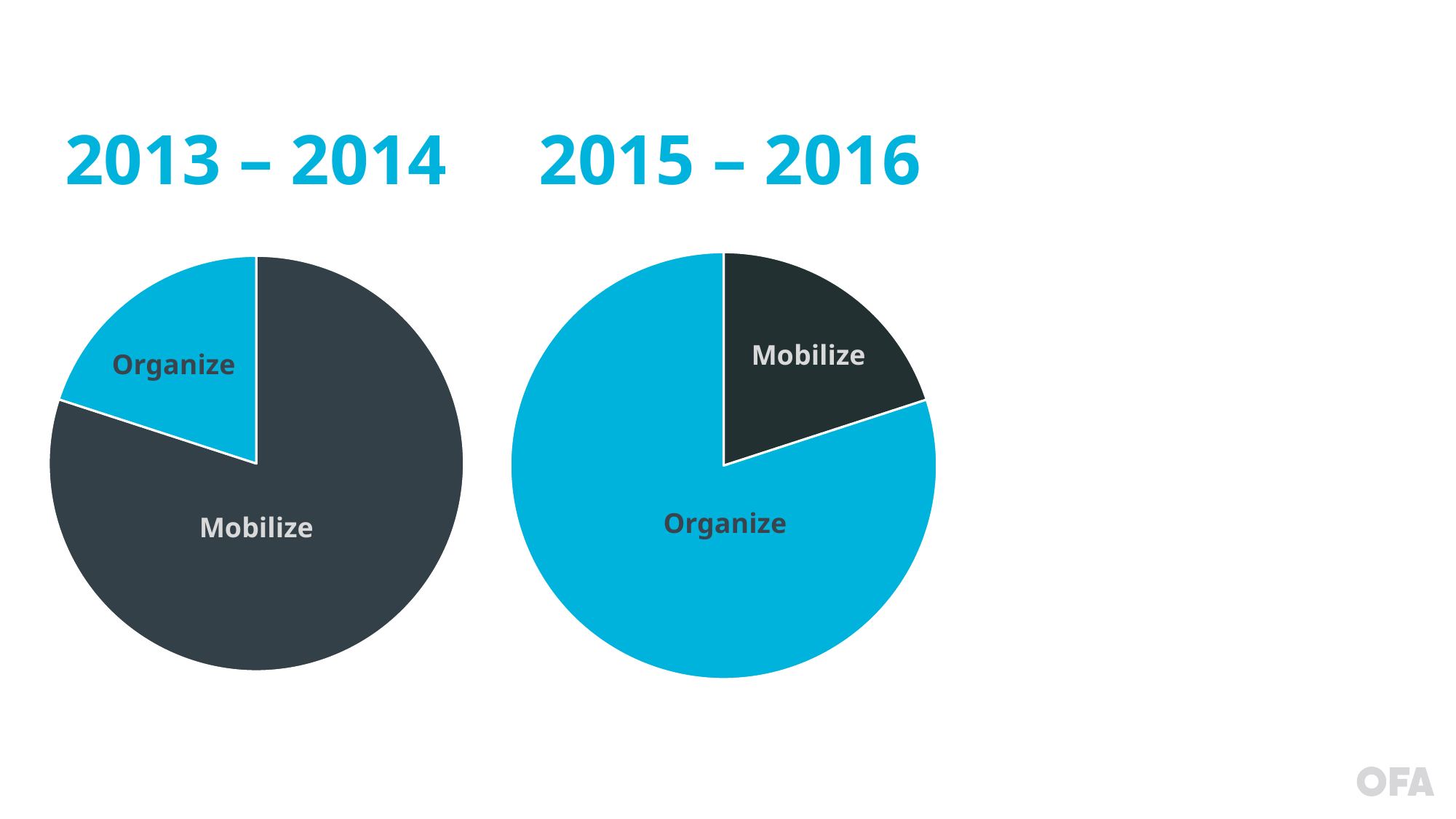
In the 2015 – 2016 chart, which slice is the smallest? Mobilize In the 2013 – 2014 chart, what kind of chart is shown? pie chart In the 2015 – 2016 chart, which is larger, Organize or Mobilize? Organize In the 2013 – 2014 chart, how many slices does the pie have? 2 In the 2013 – 2014 chart, which slice is the largest? Mobilize In the 2013 – 2014 chart, which is larger, Organize or Mobilize? Mobilize In the 2015 – 2016 chart, what kind of chart is shown? pie chart In the 2015 – 2016 chart, how many slices does the pie have? 2 In the 2013 – 2014 chart, what colour is the Organize slice? light blue In the 2013 – 2014 chart, which slice is the smallest? Organize What is the title of the chart on the right? 2015 – 2016 In the 2015 – 2016 chart, which slice is the largest? Organize